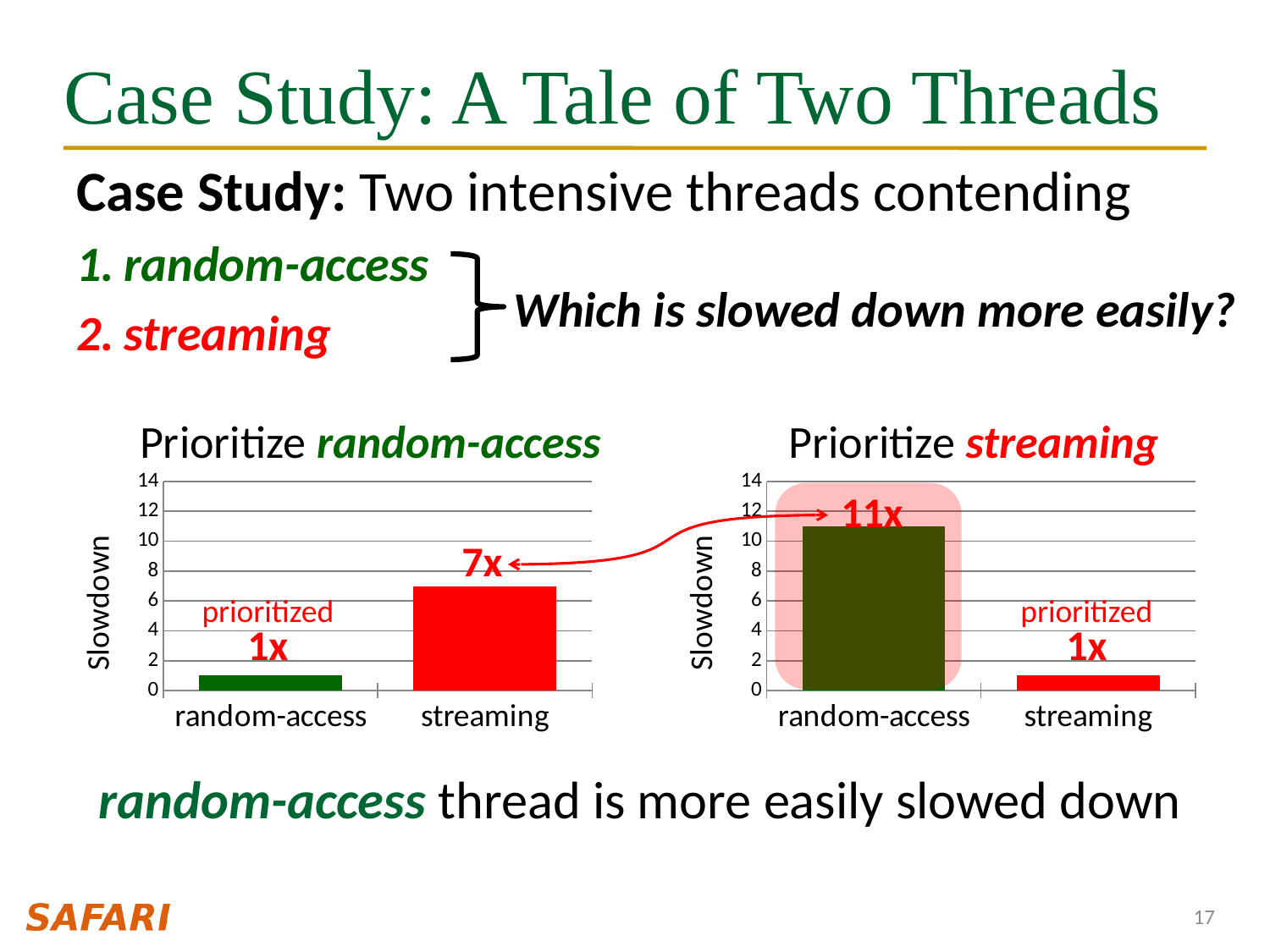
In the 'Prioritize streaming' chart, which category has the highest slowdown? random-access In the 'Prioritize random-access' chart, what is the slowdown for streaming? 7x In the 'Prioritize random-access' chart, which category has the lowest slowdown? random-access In the 'Prioritize streaming' chart, what is the slowdown for streaming? 1x How many categories are shown on the x axis of the 'Prioritize random-access' chart? 2 What is the y-axis label of the 'Prioritize random-access' chart? Slowdown Which is larger: the streaming slowdown in the 'Prioritize random-access' chart or the random-access slowdown in the 'Prioritize streaming' chart? random-access slowdown in the 'Prioritize streaming' chart What kind of chart is the 'Prioritize streaming' chart? bar chart In the 'Prioritize random-access' chart, what is the slowdown for random-access? 1x In the 'Prioritize streaming' chart, what is the slowdown for random-access? 11x In the 'Prioritize streaming' chart, what is the difference between the slowdown of random-access and streaming? 10x In the 'Prioritize streaming' chart, is the slowdown for random-access greater or less than 10? greater